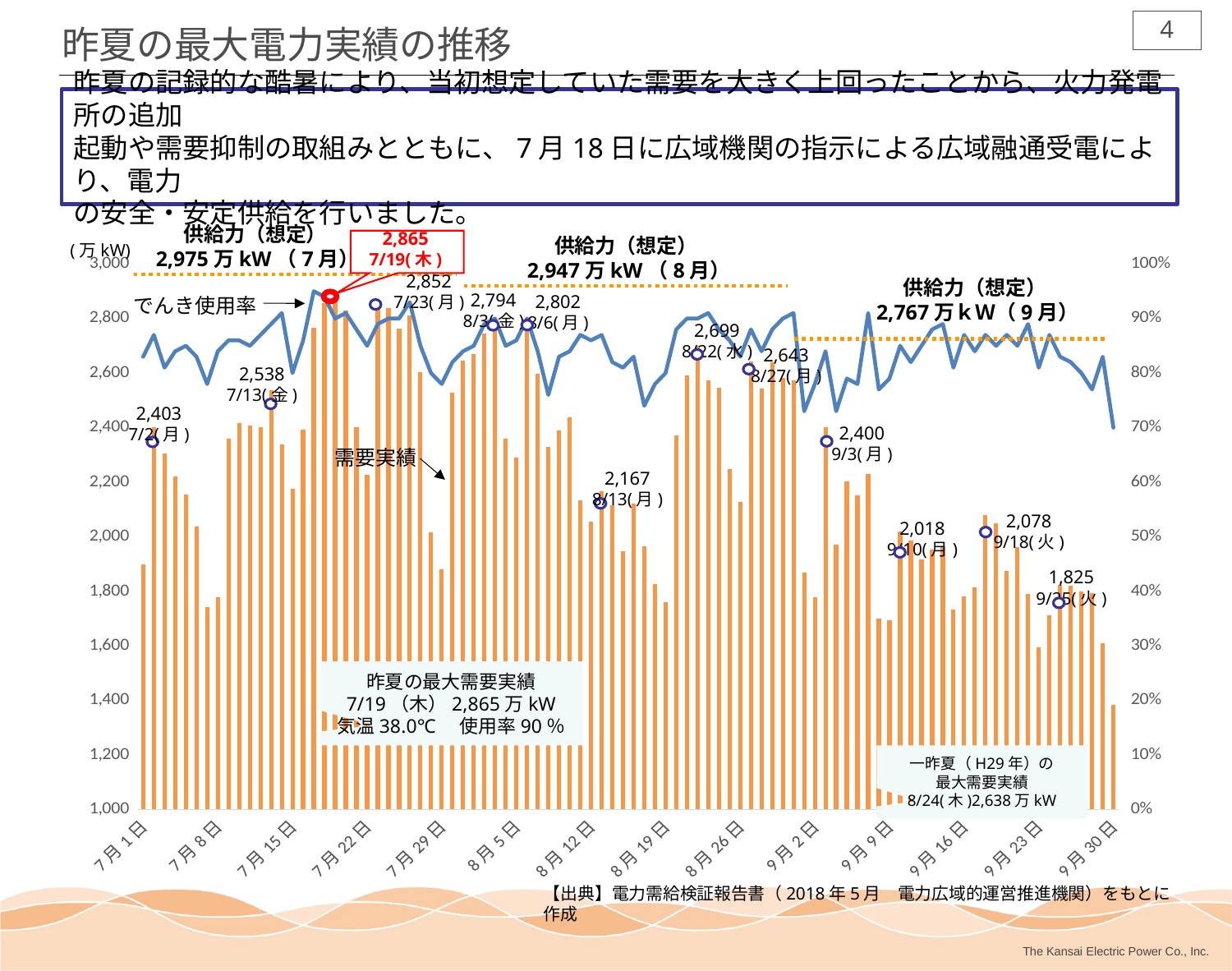
What is the labelled demand value for 8/13(月)? 2,167 What is the assumed supply capacity (供給力(想定)) shown for September? 2,767万kW What was the previous summer's (H29) maximum demand shown in the box on the chart? 2,638万kW Which labelled date has the lowest demand value on the chart? 9/25(火) What is the difference between the labelled values for 7/19(木) and 7/23(月)? 13 What is the difference between the labelled values for 9/18(火) and 9/10(月)? 60 What is the labelled peak demand value for 7/19(木)? 2,865 What type of chart is used to show the daily demand (需要実績)? Bar chart Which labelled date has the highest demand value on the chart? 7/19(木) What is the assumed supply capacity (供給力(想定)) shown for August? 2,947万kW What is the labelled demand value for 9/25(火)? 1,825 Which is larger, the labelled value for 8/22(水) or for 8/27(月)? 8/22(水)